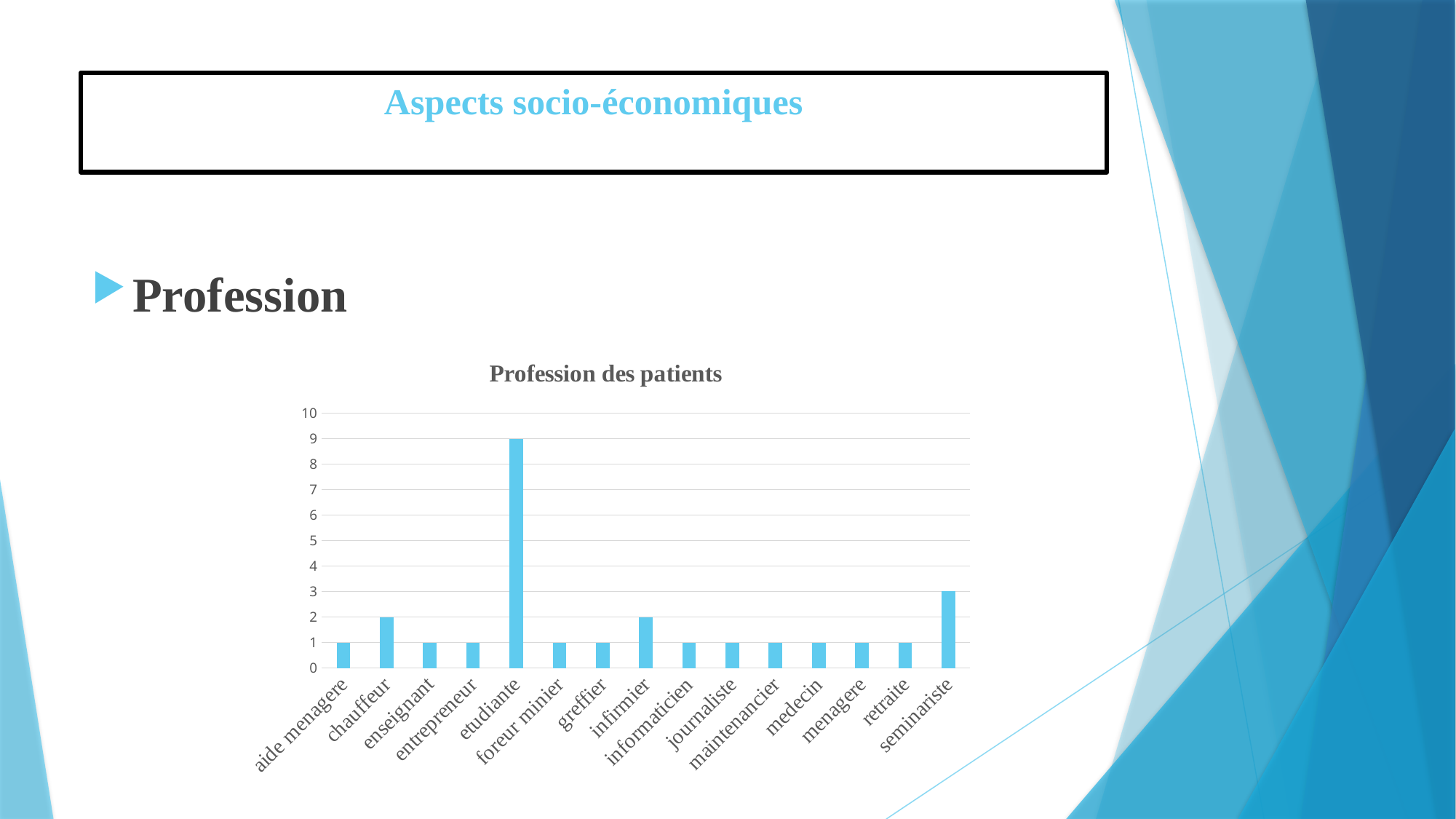
What is the title of the chart? Profession des patients Is the value for etudiante greater or less than 5? greater What is the difference between the values for etudiante and seminariste? 6 What is the value for seminariste? 3 What is the value for chauffeur? 2 Which profession has the highest value in the chart? etudiante Which is larger, the value for infirmier or the value for greffier? infirmier What is the value for medecin? 1 What is the value for etudiante? 9 What type of chart is shown on the slide? bar chart How many professions are shown on the x axis of the chart? 15 What is the maximum value shown on the y axis of the chart? 10